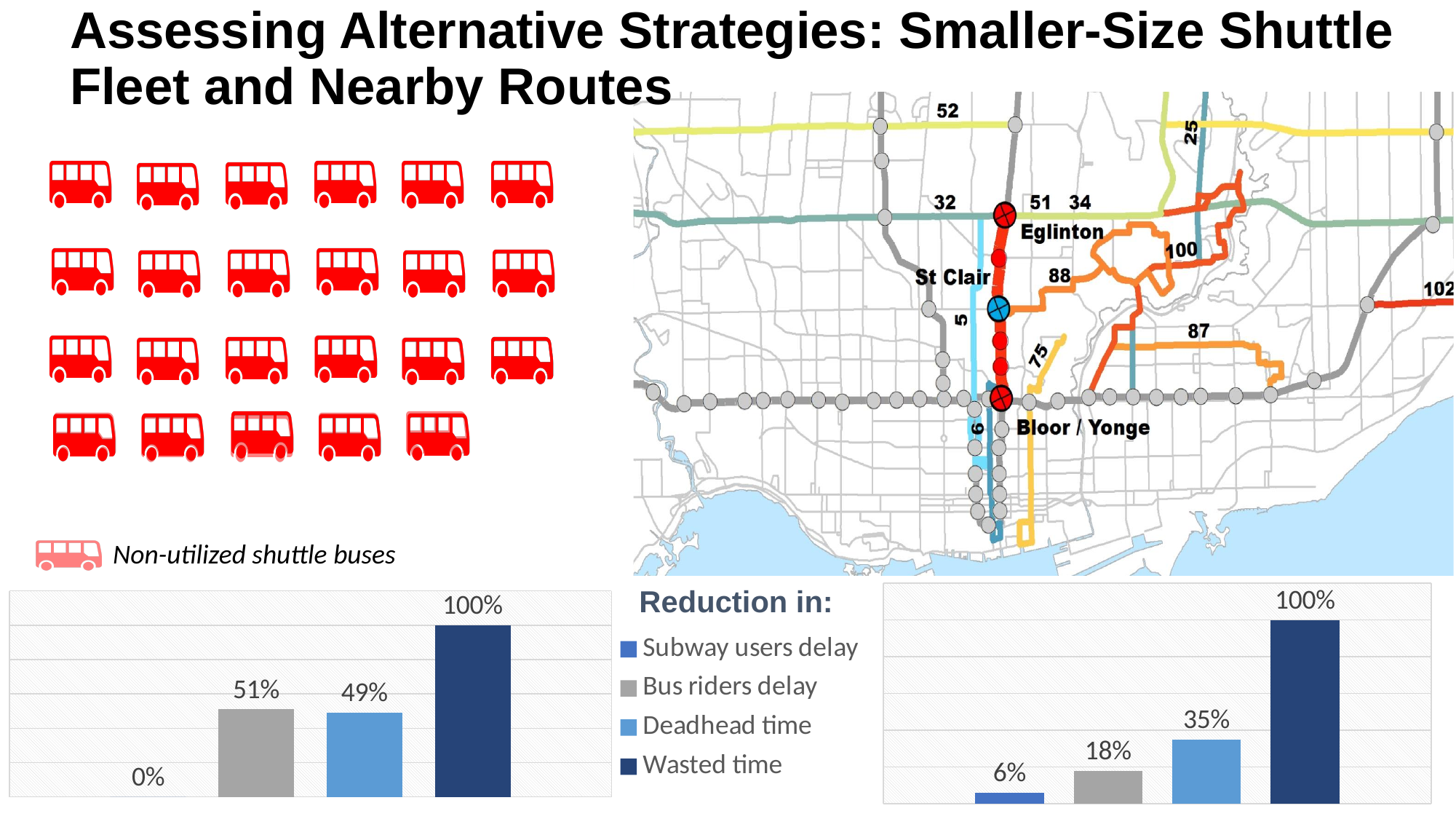
In the bottom-left bar chart, what is the reduction in Bus riders delay? 51% In the bottom-left bar chart, what is the difference between the Bus riders delay and Deadhead time values? 2% In the bottom-right bar chart, what is the reduction in Deadhead time? 35% In the bottom-right bar chart, what is the reduction in Subway users delay? 6% In the bottom-left bar chart, what is the reduction in Subway users delay? 0% How many series does the shared legend list for the bar charts? 4 In the bottom-right bar chart, which series has the lowest value? Subway users delay In the bottom-right bar chart, what is the difference between the Deadhead time and Bus riders delay values? 17% In the bottom-left bar chart, which series has the highest value? Wasted time In the bottom-left bar chart, what is the reduction in Wasted time? 100% What type of chart is shown at the bottom right of the slide? bar chart Is the Bus riders delay reduction larger in the bottom-left chart or the bottom-right chart? bottom-left chart